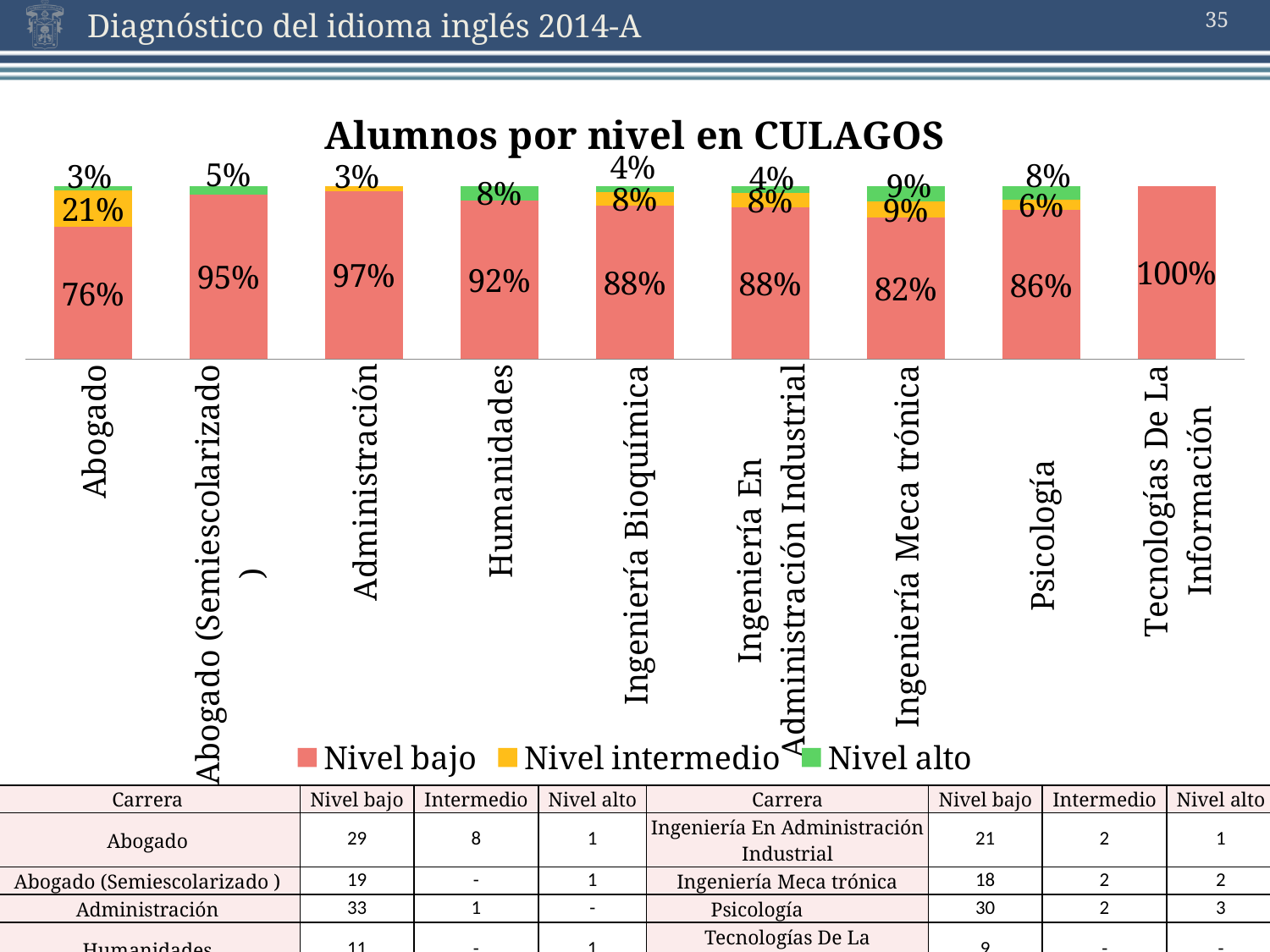
What is the Nivel bajo value for Ingeniería Mecatrónica? 82% What is the Nivel intermedio value for Abogado? 21% What kind of chart is shown? Stacked bar chart How many categories (carreras) are shown on the x axis? 9 What is the difference between the Nivel bajo values for Administración and Abogado? 21 percentage points Which has a larger Nivel bajo value, Humanidades or Psicología? Humanidades Which category has the highest Nivel bajo value? Tecnologías De La Información How many series does the legend list? 3 What is the Nivel bajo value for Abogado? 76% Which category has the lowest Nivel bajo value? Abogado Which category has the highest Nivel intermedio value? Abogado What is the Nivel alto value for Psicología? 8%